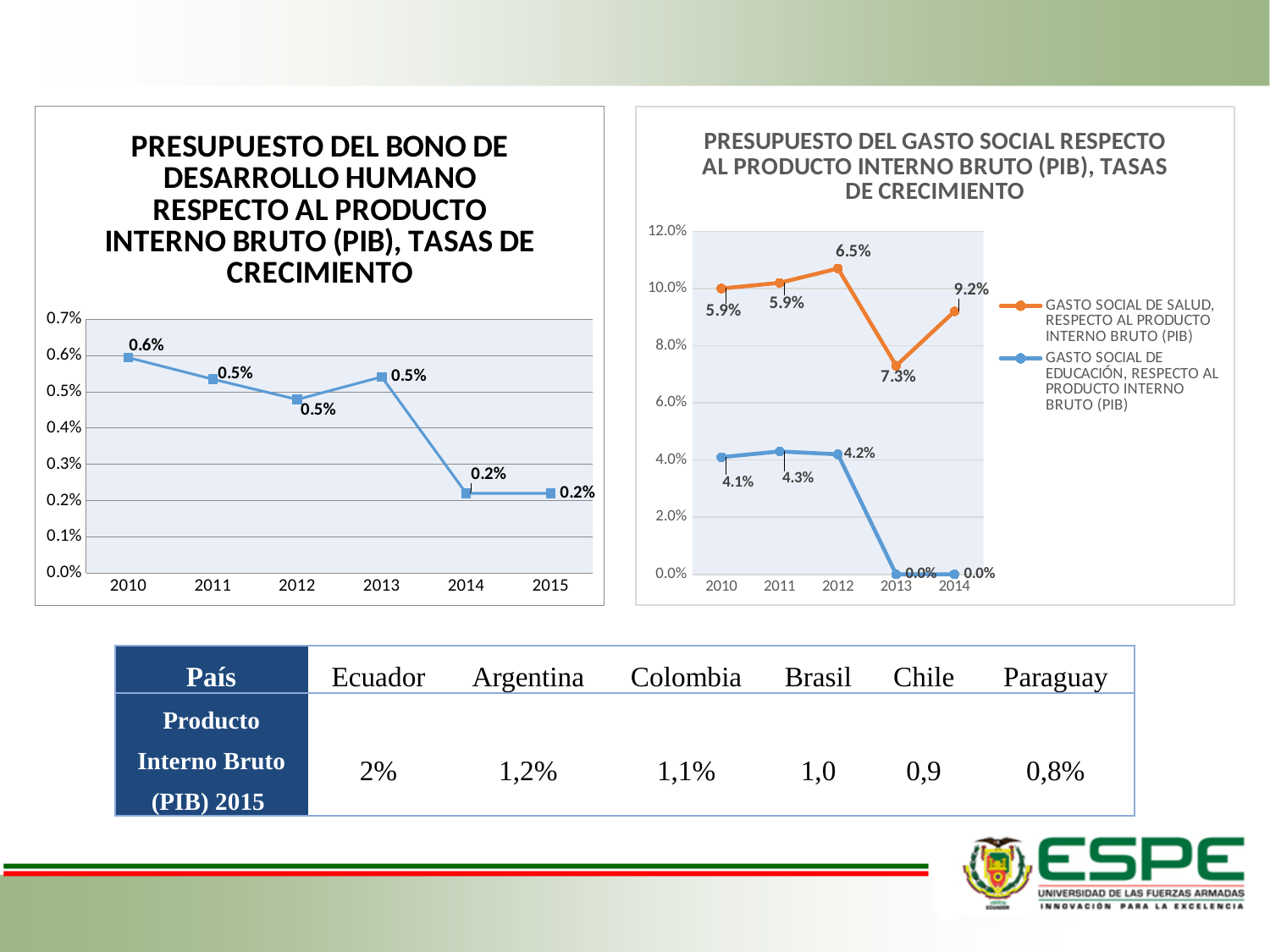
On the left chart (Presupuesto del Bono de Desarrollo Humano), what is the difference between the 2010 value and the 2015 value? 0.4% On the left chart (Presupuesto del Bono de Desarrollo Humano), how many years are plotted? 6 What kind of chart is the left chart (Presupuesto del Bono de Desarrollo Humano)? line chart On the right chart (Presupuesto del Gasto Social), what is the labelled value for Gasto Social de Educación in 2010? 4.1% On the right chart (Presupuesto del Gasto Social), what is the labelled value for Gasto Social de Salud in 2014? 9.2% On the left chart (Presupuesto del Bono de Desarrollo Humano), which year has the highest value? 2010 On the left chart (Presupuesto del Bono de Desarrollo Humano), do the values generally rise or fall from 2010 to 2015? fall On the left chart (Presupuesto del Bono de Desarrollo Humano), what is the value for 2010? 0.6% On the right chart (Presupuesto del Gasto Social), how many series does the legend list? 2 On the right chart (Presupuesto del Gasto Social), in which year is the Gasto Social de Educación value highest? 2011 On the left chart (Presupuesto del Bono de Desarrollo Humano), what is the value for 2015? 0.2% On the right chart (Presupuesto del Gasto Social), in 2012 which series has the larger value, Gasto Social de Salud or Gasto Social de Educación? Gasto Social de Salud